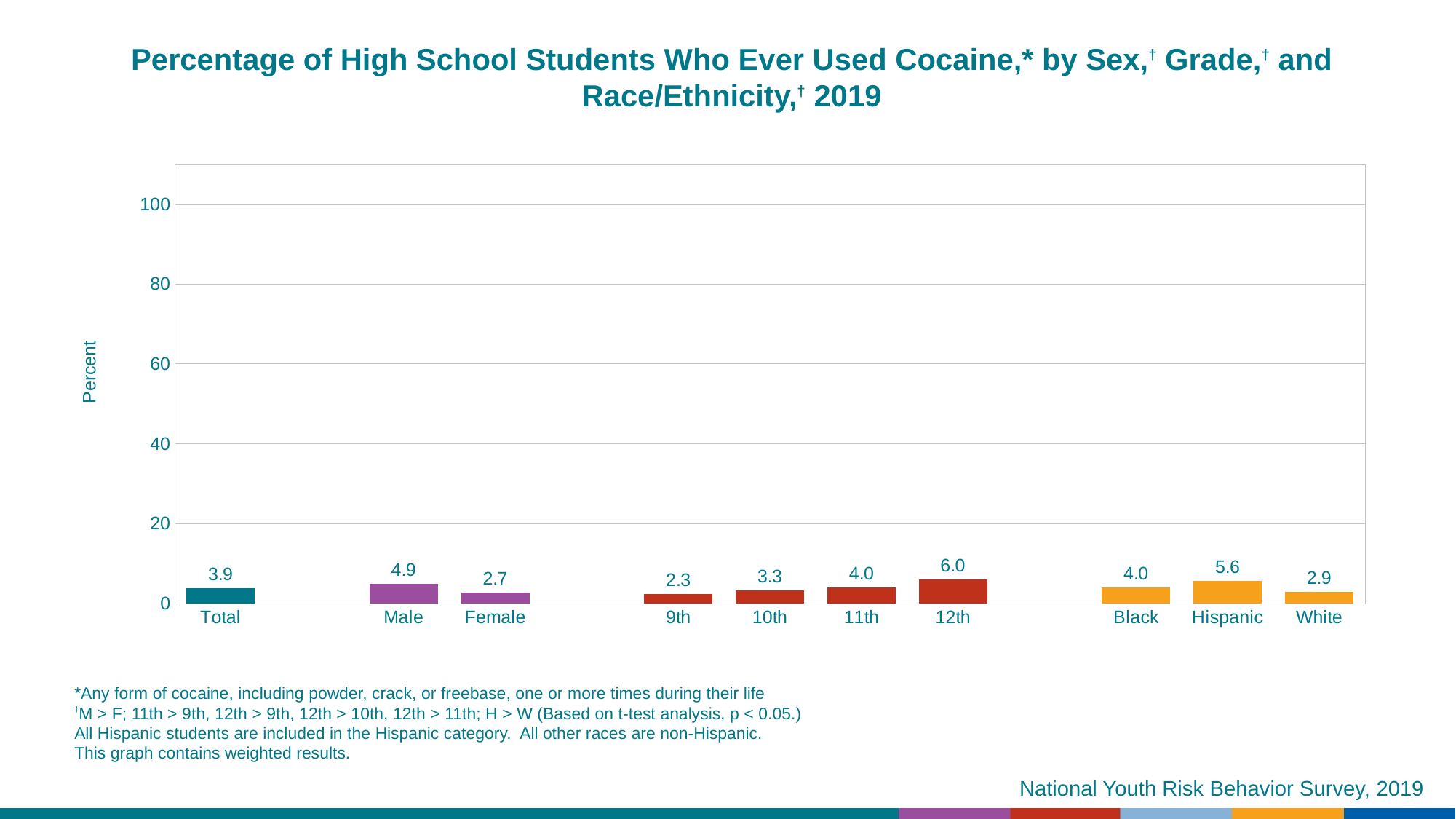
Do the values rise or fall from 9th grade to 12th grade? rise What percentage of male high school students ever used cocaine? 4.9 How many categories are shown on the x axis? 10 Which category has the highest percentage on the chart? 12th What kind of chart is shown on the slide? bar chart What is the value shown for 12th grade students? 6.0 What is the value shown for the Total category? 3.9 Is the value for 12th grade students greater or less than 20? less What is the difference between the Male and Female values? 2.2 What is the value shown for Hispanic students? 5.6 Which is larger, the value for Hispanic students or the value for White students? Hispanic Which category has the lowest percentage on the chart? 9th